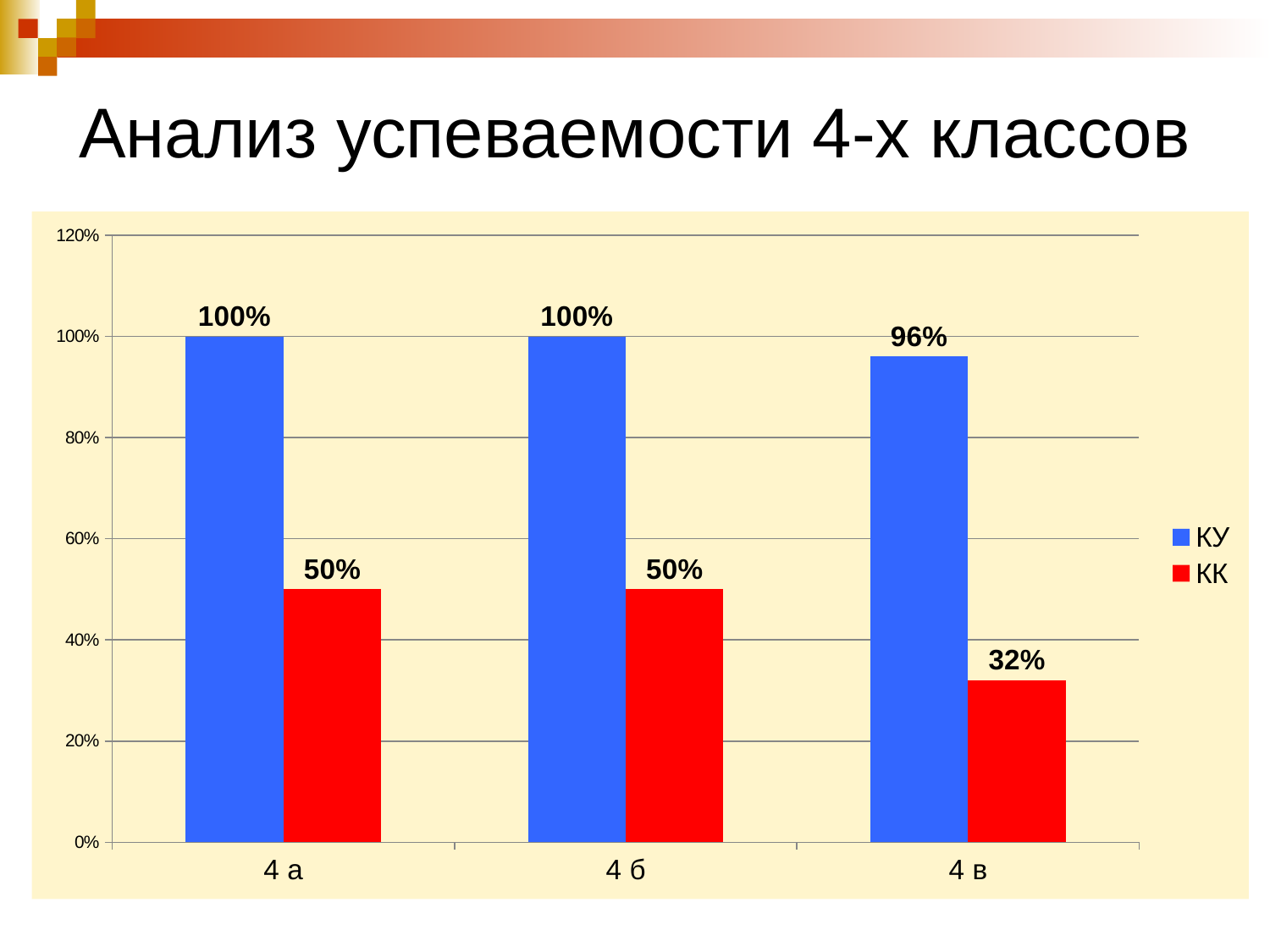
What kind of chart is shown on the slide? Bar chart What is the КК value for class 4 б? 50% How many classes are shown on the x axis? 3 Which class has the lowest КУ value? 4 в What is the КУ value for class 4 в? 96% Which is larger for class 4 б, the КУ value or the КК value? КУ Which class has the lowest КК value? 4 в What is the КУ value for class 4 а? 100% What is the difference between the КУ and КК values for class 4 в? 64% What is the difference between the КК values for class 4 а and class 4 в? 18% How many series does the legend list? 2 What is the КК value for class 4 в? 32%